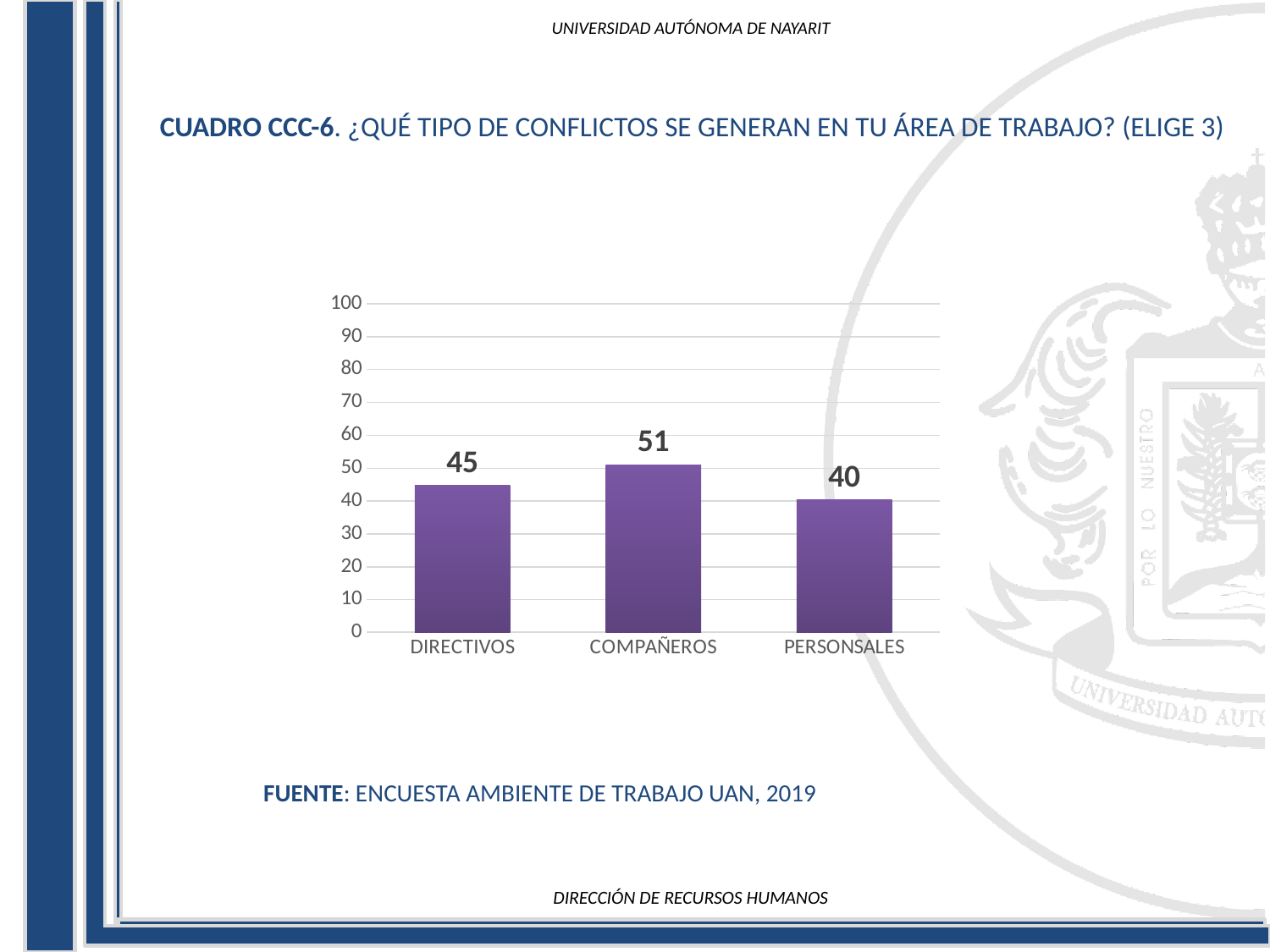
How many categories are shown in the chart? 3 Which category has the highest value? COMPAÑEROS Which is larger, the value for DIRECTIVOS or the value for PERSONSALES? DIRECTIVOS What is the difference between the values for COMPAÑEROS and DIRECTIVOS? 6 What is the value for DIRECTIVOS? 45 What kind of chart is shown on the slide? bar chart Is the value for COMPAÑEROS greater or less than 50? greater Which category has the lowest value? PERSONSALES What is the maximum value shown on the vertical axis? 100 What is the value for PERSONSALES? 40 What is the value for COMPAÑEROS? 51 What is the difference between the values for COMPAÑEROS and PERSONSALES? 11